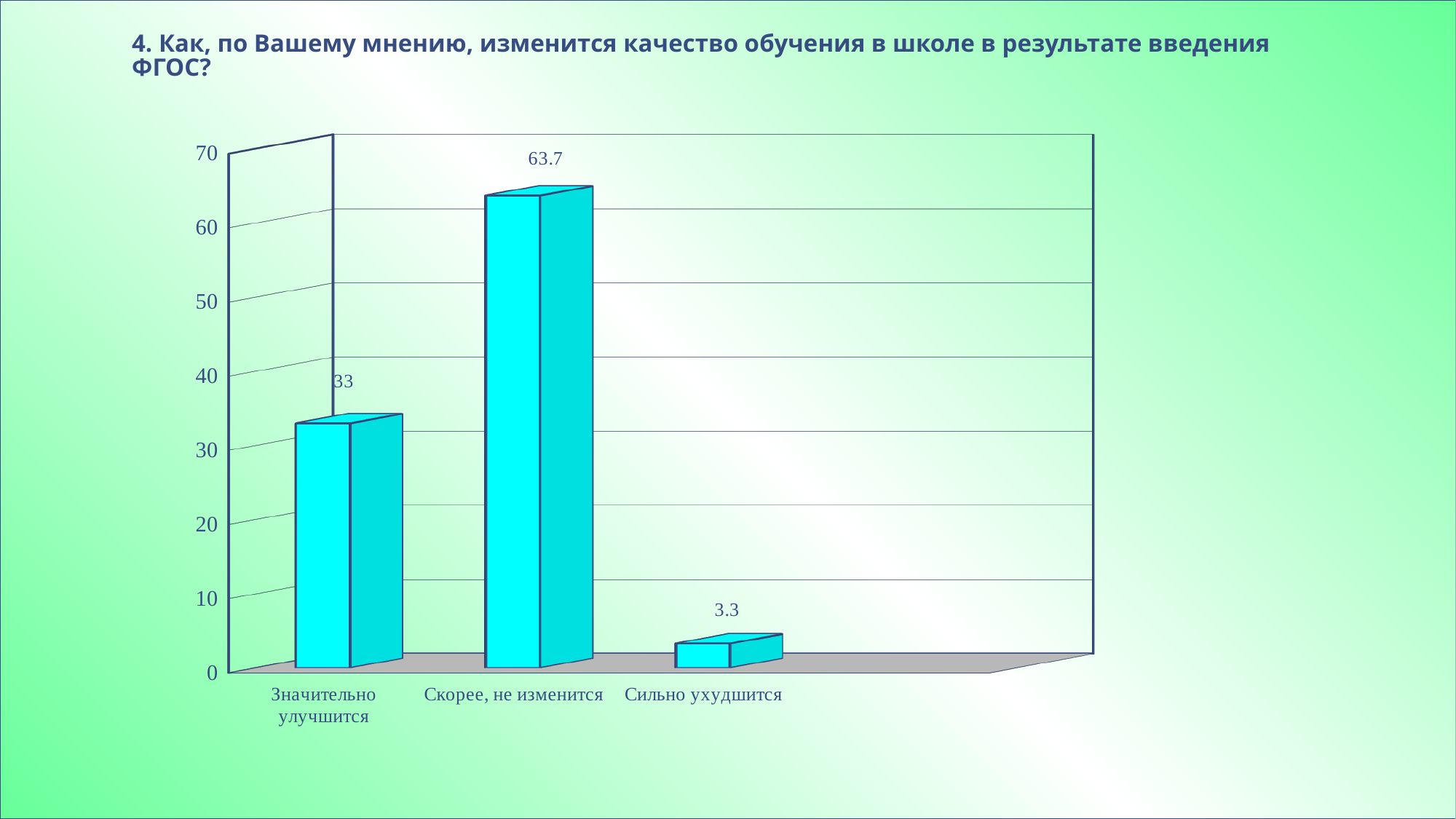
Which is larger: the value for "Значительно улучшится" or the value for "Сильно ухудшится"? Значительно улучшится Which category has the highest value? Скорее, не изменится What is the highest value shown on the vertical axis? 70 What is the difference between the values for "Значительно улучшится" and "Сильно ухудшится"? 29.7 What is the value for "Сильно ухудшится"? 3.3 What kind of chart is shown on the slide? bar chart What is the value for "Значительно улучшится"? 33 Which category has the lowest value? Сильно ухудшится What is the difference between the values for "Скорее, не изменится" and "Значительно улучшится"? 30.7 How many categories are shown on the x axis? 3 What is the value for "Скорее, не изменится"? 63.7 Is the value for "Скорее, не изменится" greater or less than 60? greater